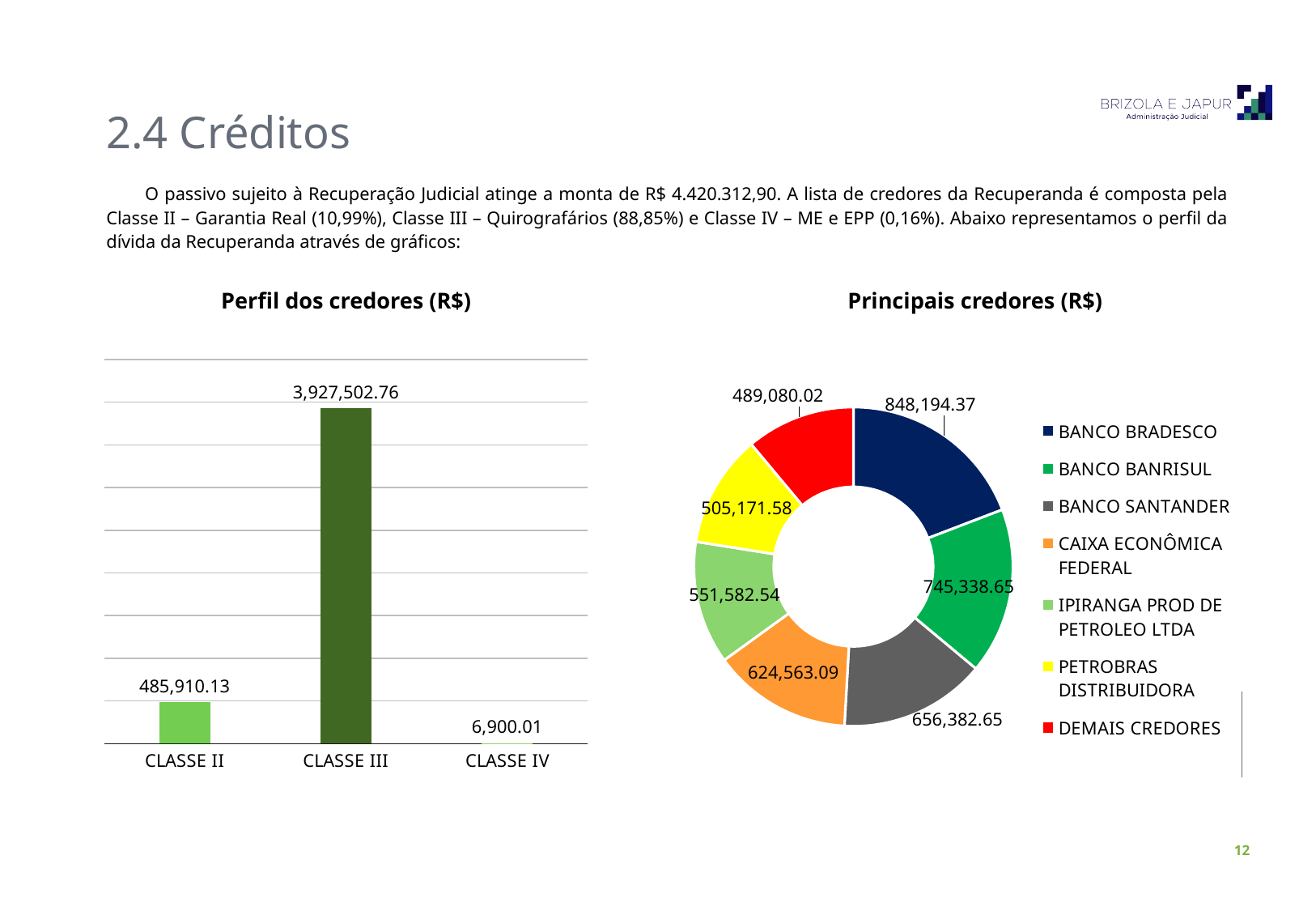
In the 'Principais credores (R$)' chart, what is the value for IPIRANGA PROD DE PETROLEO LTDA? 551,582.54 In the 'Principais credores (R$)' chart, what is the value for BANCO SANTANDER? 656,382.65 In the 'Principais credores (R$)' chart, which creditor has the largest value? BANCO BRADESCO What kind of chart is 'Perfil dos credores (R$)'? Bar chart In the 'Principais credores (R$)' chart, what is the difference between BANCO BRADESCO and BANCO BANRISUL? 102,855.72 In the 'Perfil dos credores (R$)' chart, how many classes are shown on the x axis? 3 In the 'Principais credores (R$)' chart, which is larger: CAIXA ECONÔMICA FEDERAL or PETROBRAS DISTRIBUIDORA? CAIXA ECONÔMICA FEDERAL In the 'Perfil dos credores (R$)' chart, which class has the lowest value? CLASSE IV In the 'Perfil dos credores (R$)' chart, what is the value for CLASSE IV? 6,900.01 In the 'Perfil dos credores (R$)' chart, what is the difference between CLASSE III and CLASSE II? 3,441,592.63 In the 'Perfil dos credores (R$)' chart, what is the value for CLASSE III? 3,927,502.76 How many entries does the legend of the 'Principais credores (R$)' chart list? 7